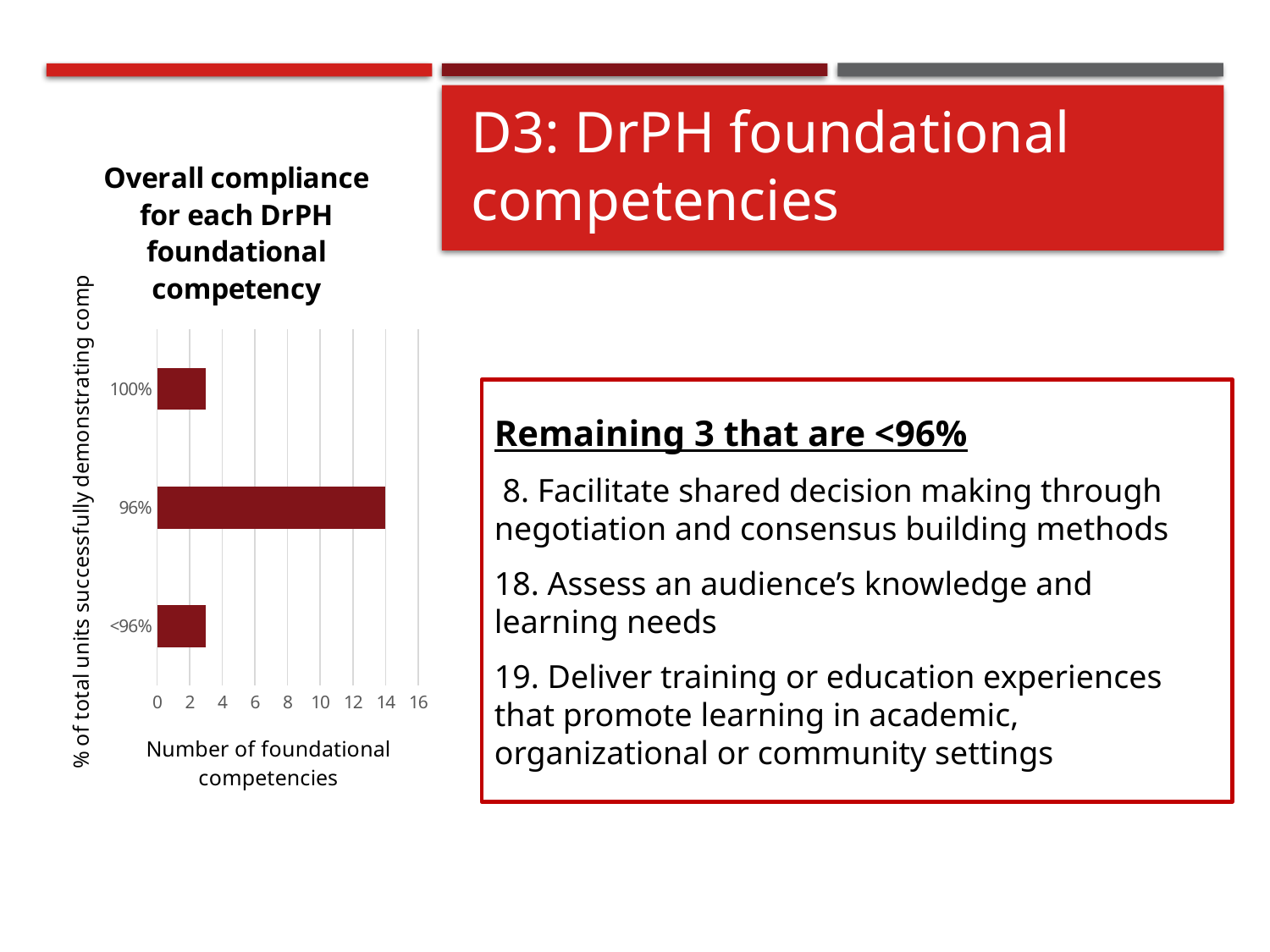
What is the title of the chart? Overall compliance for each DrPH foundational competency Is the number of foundational competencies in the <96% category greater or less than 4? less Which category has more foundational competencies, 96% or 100%? 96% How many compliance categories are plotted in the chart? 3 Which category has more foundational competencies, <96% or 96%? 96% How many foundational competencies fall in the 96% compliance category? 14 What kind of chart is shown on the slide? bar chart Is the number of foundational competencies in the 100% category greater or less than 2? greater What is the label of the horizontal axis of the chart? Number of foundational competencies Which compliance category has the highest number of foundational competencies? 96% Is the number of foundational competencies in the 96% category greater or less than 10? greater